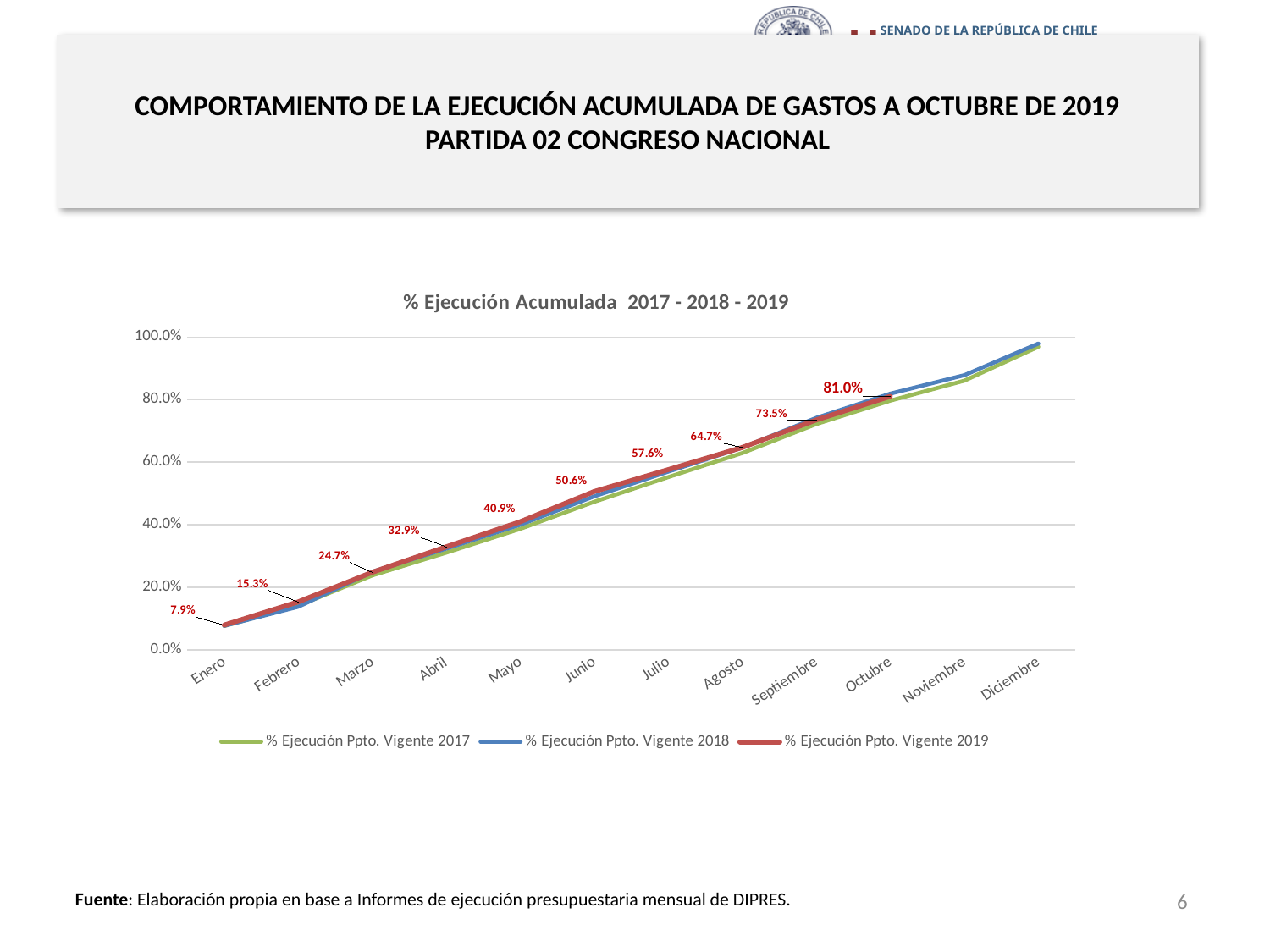
What is the value for % Ejecución Ppto. Vigente 2019 in Enero? 7.9% What type of chart is shown on the slide? line chart How many series does the legend list? 3 In which month is the % Ejecución Ppto. Vigente 2019 series lowest? Enero What is the value for % Ejecución Ppto. Vigente 2019 in Agosto? 64.7% How many months are shown on the x axis? 12 What is the value for % Ejecución Ppto. Vigente 2019 in Mayo? 40.9% Is the value for % Ejecución Ppto. Vigente 2018 in Diciembre greater or less than 80.0%? greater Do the values for % Ejecución Ppto. Vigente 2019 rise or fall from Enero to Octubre? rise What is the title of the chart? % Ejecución Acumulada 2017 - 2018 - 2019 What is the value for % Ejecución Ppto. Vigente 2019 in Octubre? 81.0% What is the difference between the 2019 values for Octubre and Septiembre? 7.5%